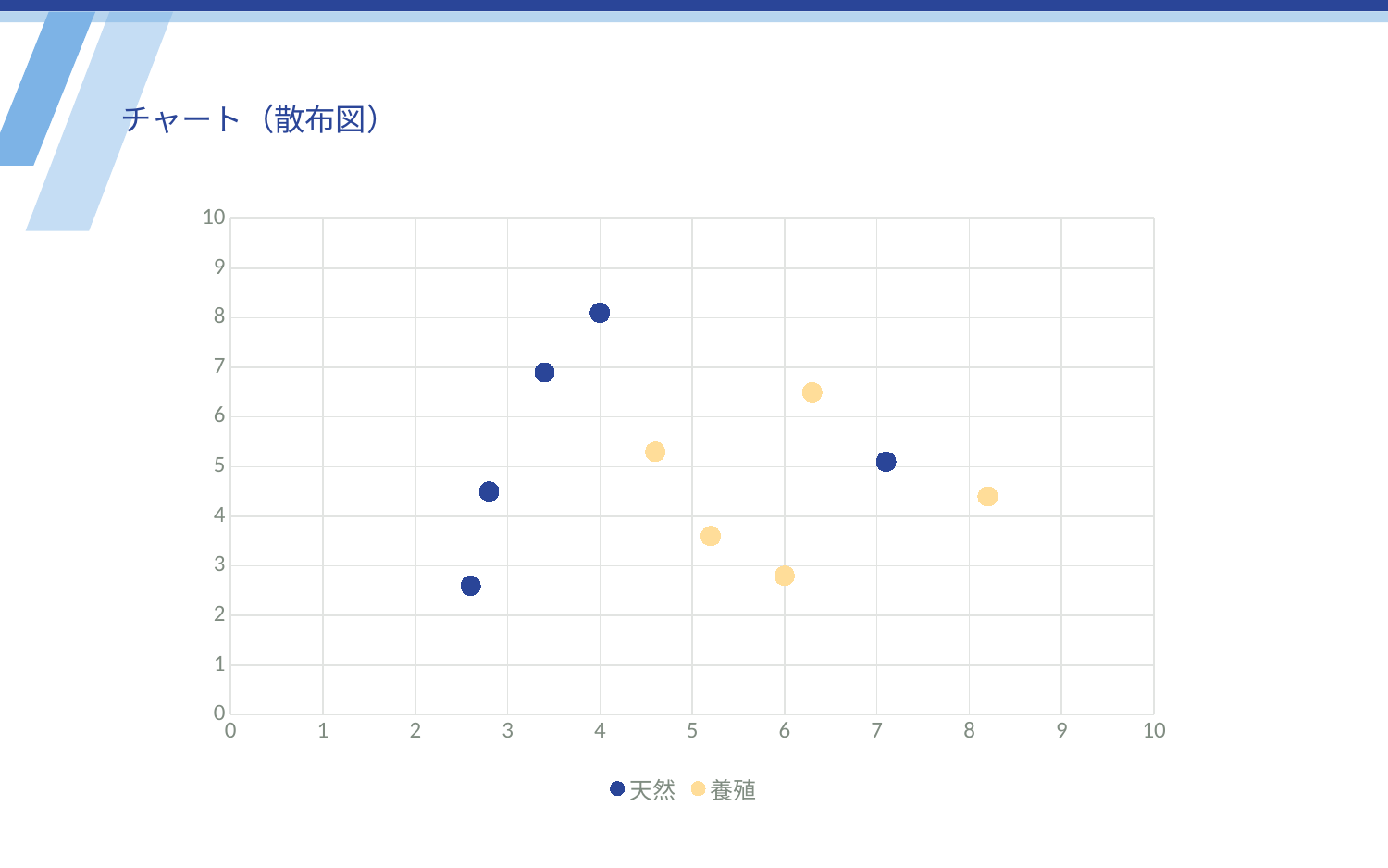
What is the title of the slide? チャート（散布図） How many points are plotted in total across both series? 10 Which series contains the point with the largest x value? 養殖 Is the y value of the highest 天然 point greater or less than 7? greater What kind of chart is shown on the slide? scatter chart Is the y value of the highest 養殖 point greater or less than 6? greater How many 養殖 points are plotted on the chart? 5 Is the y value of the 養殖 point with the largest x value greater or less than 5? less Which series contains the point with the highest y value? 天然 What are the two series names shown in the legend? 天然 and 養殖 How many series does the legend list? 2 How many 天然 points are plotted on the chart? 5